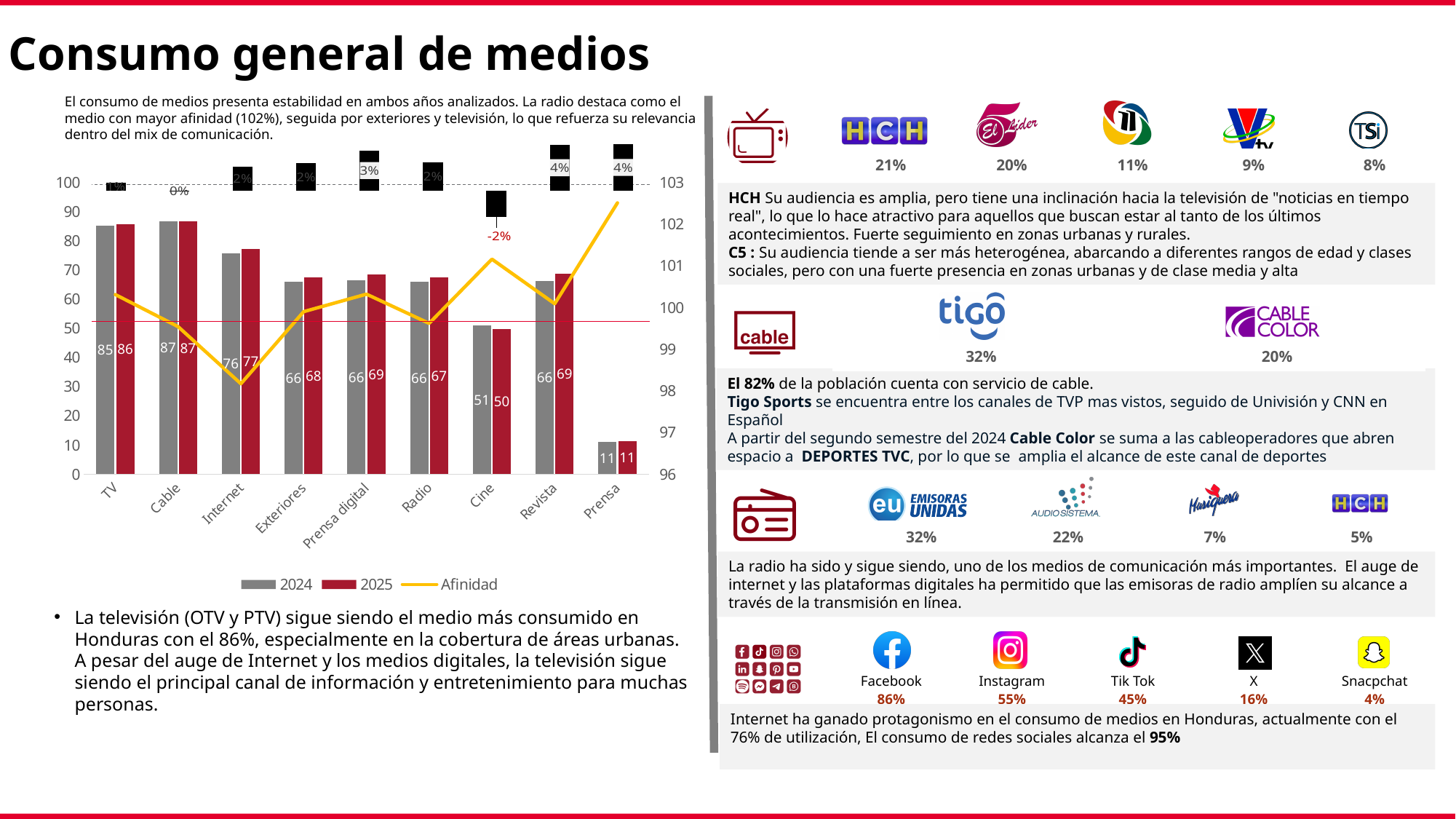
How many media categories are shown on the x axis of the chart? 9 What is the 2024 value for Cine in the chart? 51 Which series in the chart is drawn as a yellow line? Afinidad Which is larger for Cine: the 2024 value or the 2025 value? 2024 Which category has the highest 2025 value in the chart? Cable What is the 2025 value for Prensa digital in the chart? 69 What is the 2025 value for TV in the chart? 86 Which category has the lowest 2024 value in the chart? Prensa What is the difference between the 2025 and 2024 values for Revista? 3 What kind of chart is shown on the slide? Combined bar and line chart Is the Afinidad value for Prensa greater or less than 102? greater How many series does the chart legend list? 3